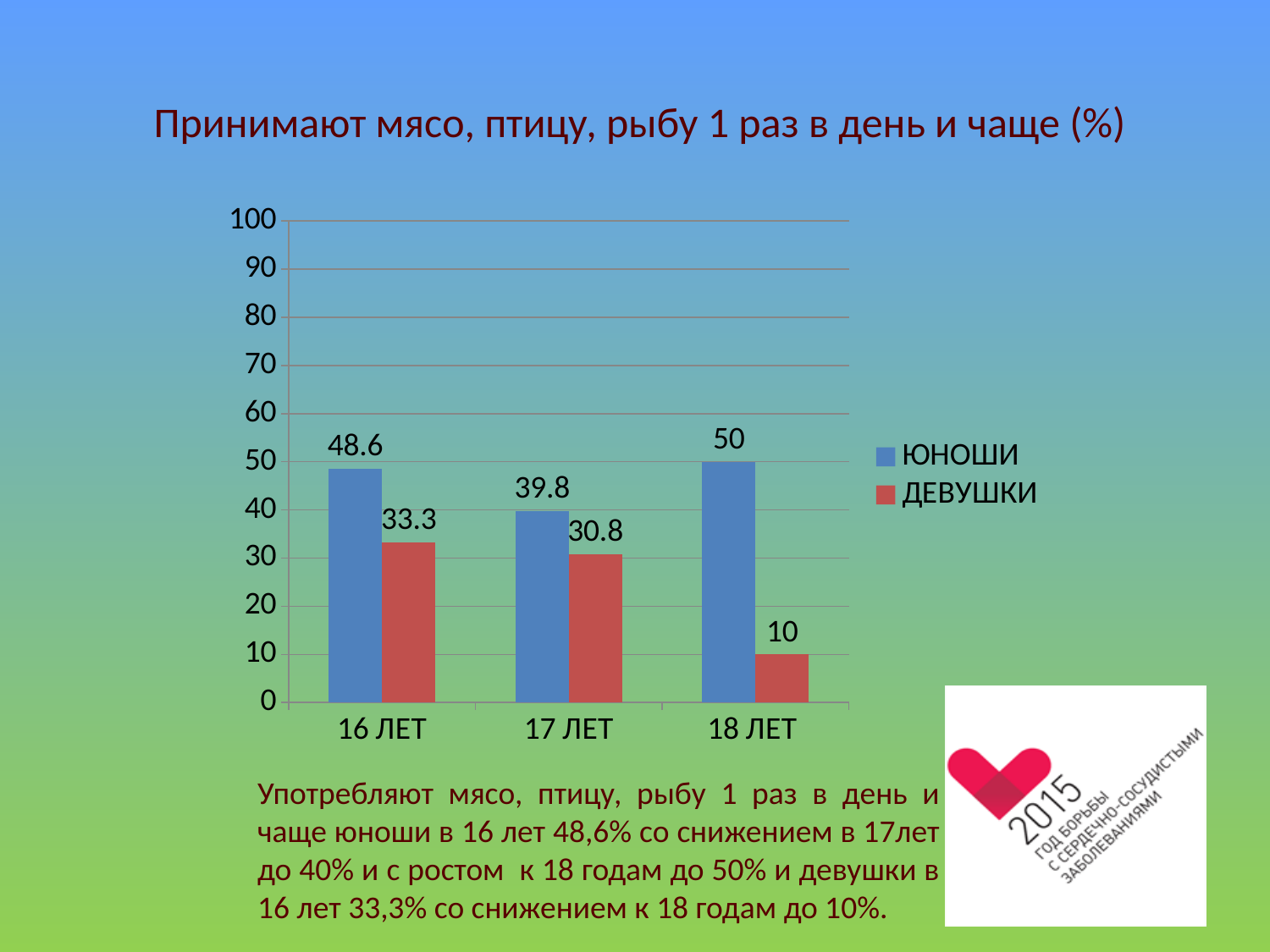
How many series does the legend list? 2 At which age group is the ДЕВУШКИ value lowest? 18 ЛЕТ What is the value for ДЕВУШКИ at 18 ЛЕТ? 10 What kind of chart is shown on the slide? bar chart Is the value for ДЕВУШКИ at 16 ЛЕТ greater or less than 40? less What is the value for ДЕВУШКИ at 17 ЛЕТ? 30.8 What is the difference between the ЮНОШИ and ДЕВУШКИ values at 18 ЛЕТ? 40 How many age groups are shown on the x axis? 3 What is the difference between the ЮНОШИ values at 16 ЛЕТ and 17 ЛЕТ? 8.8 At which age group is the ЮНОШИ value highest? 18 ЛЕТ What is the value for ЮНОШИ at 16 ЛЕТ? 48.6 Which is larger at 17 ЛЕТ, the ЮНОШИ value or the ДЕВУШКИ value? ЮНОШИ